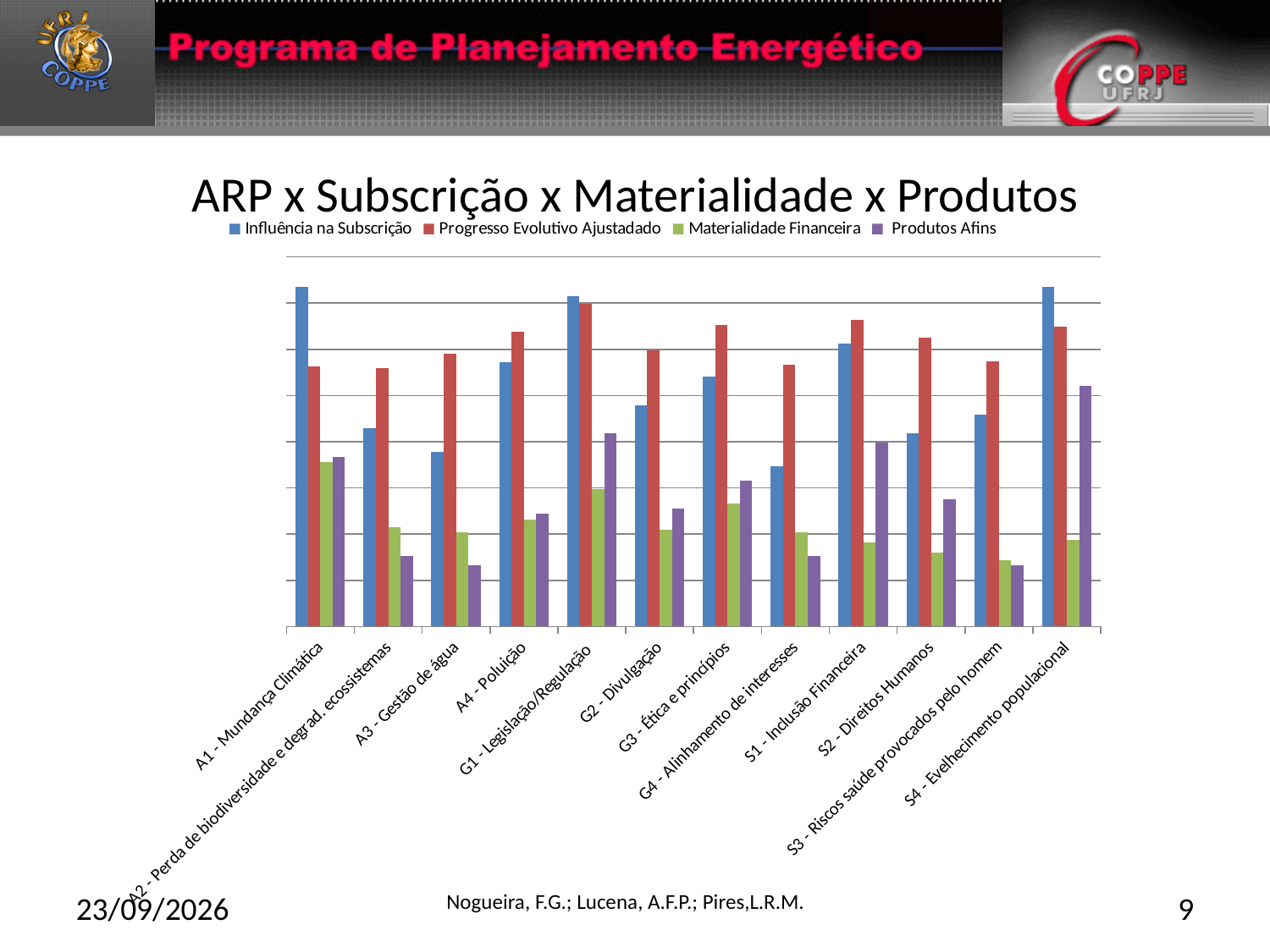
For S2 - Direitos Humanos, which is larger: Materialidade Financeira or Produtos Afins? Produtos Afins For A4 - Poluição, which series has the highest value? Progresso Evolutivo Ajustadado Which category has the highest value for Produtos Afins? S4 - Evelhecimento populacional Which category has the highest value for Materialidade Financeira? A1 - Mundança Climática What kind of chart is shown on the slide? Bar chart How many series does the legend list? 4 Which series is shown in purple in the legend? Produtos Afins For G3 - Ética e princípios, which is larger: Influência na Subscrição or Progresso Evolutivo Ajustadado? Progresso Evolutivo Ajustadado How many categories are shown along the x axis? 12 What is the title of the chart? ARP x Subscrição x Materialidade x Produtos For A1 - Mundança Climática, which is larger: Influência na Subscrição or Progresso Evolutivo Ajustadado? Influência na Subscrição